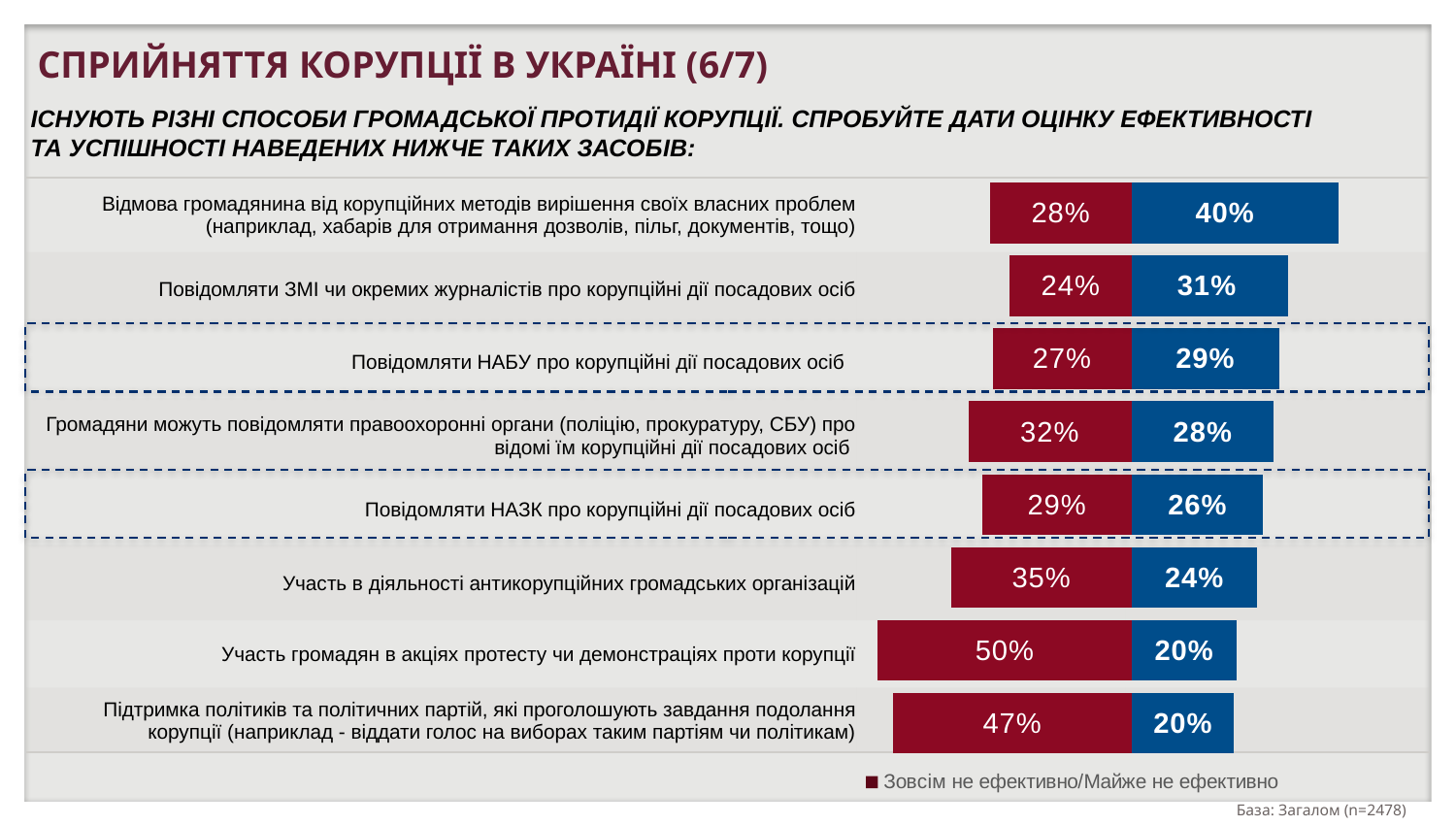
What is the red ('Зовсім не ефективно/Майже не ефективно') value for 'Участь в діяльності антикорупційних громадських організацій'? 35% What is the value of the blue series for 'Повідомляти ЗМІ чи окремих журналістів про корупційні дії посадових осіб'? 31% For 'Участь громадян в акціях протесту чи демонстраціях проти корупції', how much larger is the red value than the blue value? 30 percentage points What type of chart is shown on the slide? Bar chart For 'Повідомляти НАЗК про корупційні дії посадових осіб', which is larger: the red value or the blue value? The red value (29%) How many categories (methods) are shown in the chart? 8 Which category has the lowest 'Зовсім не ефективно/Майже не ефективно' (red) value? Повідомляти ЗМІ чи окремих журналістів про корупційні дії посадових осіб Which category has the highest blue-series value? Відмова громадянина від корупційних методів вирішення своїх власних проблем What is the value of the 'Зовсім не ефективно/Майже не ефективно' (red) series for 'Повідомляти НАБУ про корупційні дії посадових осіб'? 27% Which category has the highest 'Зовсім не ефективно/Майже не ефективно' (red) value? Участь громадян в акціях протесту чи демонстраціях проти корупції What is the legend entry shown for the red series? Зовсім не ефективно/Майже не ефективно What is the combined total of the red and blue values for 'Відмова громадянина від корупційних методів вирішення своїх власних проблем'? 68%